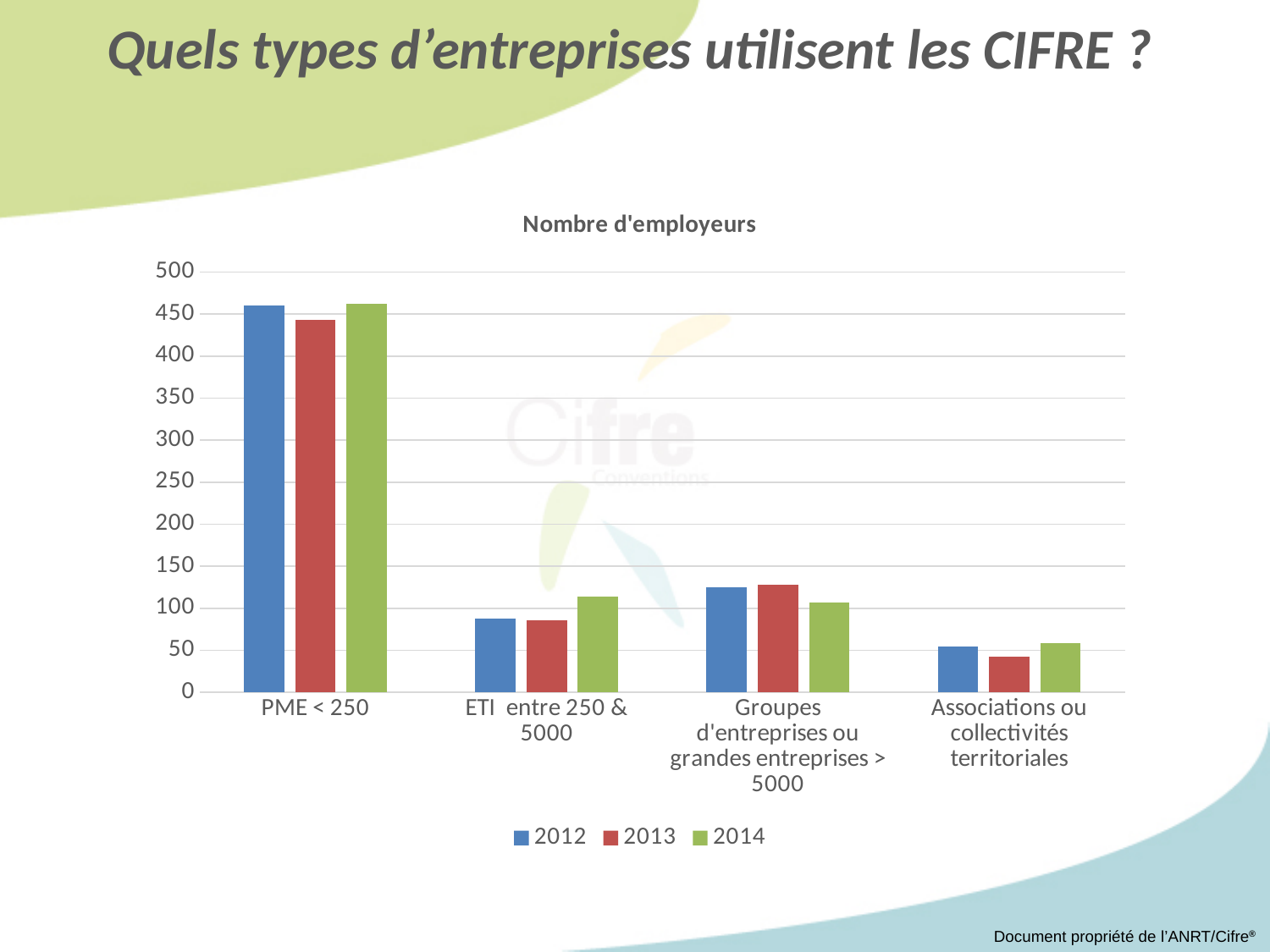
Is the 2013 value for Associations ou collectivités territoriales greater or less than 50? less What type of chart is shown on the slide? bar chart For ETI entre 250 & 5000, which year has the larger value, 2012 or 2014? 2014 How many series does the legend list? 3 Which category has the highest number of employers in 2014? PME < 250 Is the 2013 value for PME < 250 greater or less than 400? greater Is the 2012 value for ETI entre 250 & 5000 greater or less than 100? less What is the title of the chart? Nombre d'employeurs How many employer categories are shown on the x axis? 4 Which category has the lowest number of employers in 2013? Associations ou collectivités territoriales For Groupes d'entreprises ou grandes entreprises > 5000, which year has the larger value, 2013 or 2014? 2013 Which colour represents the 2013 series in the legend? red